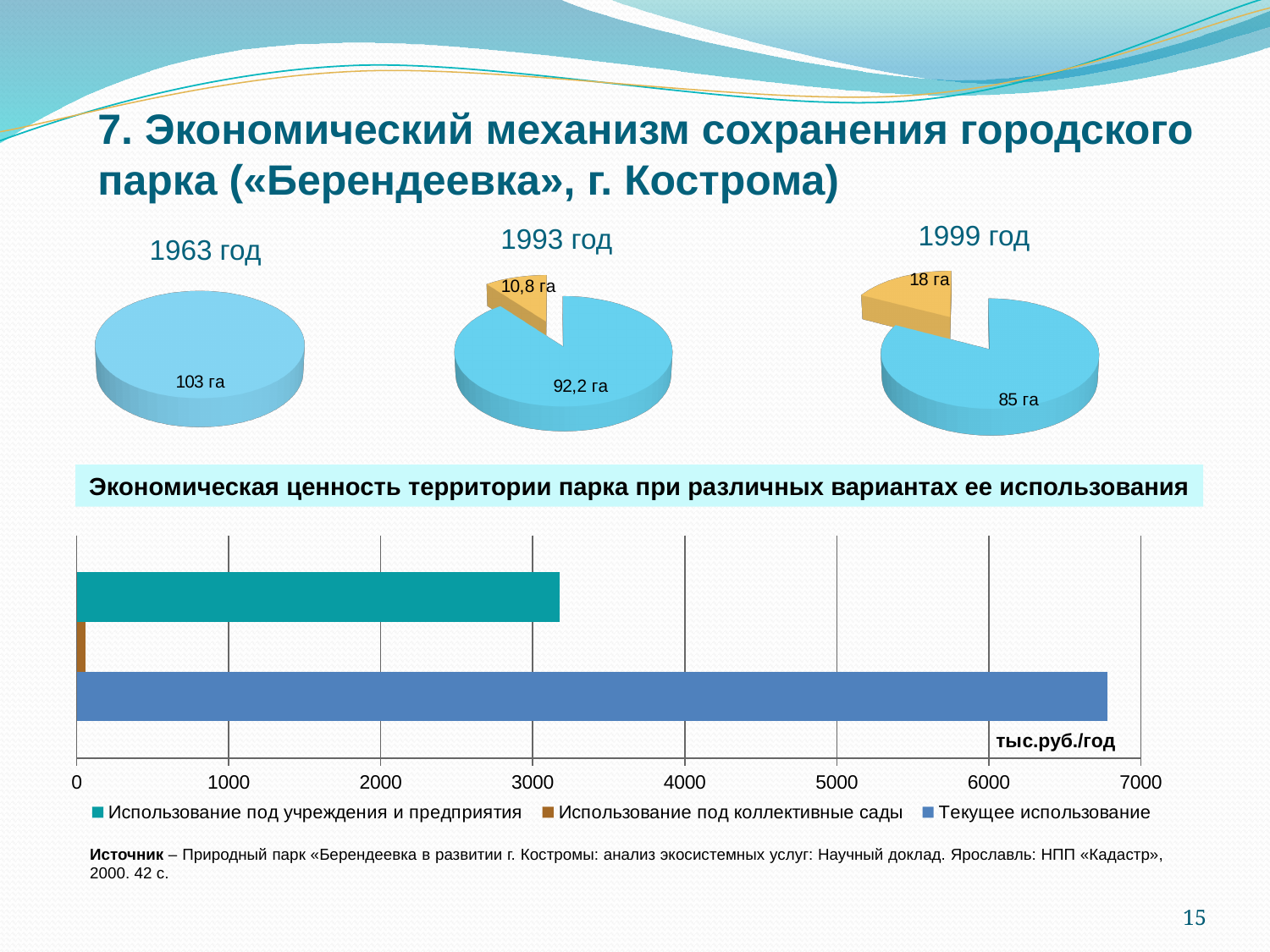
In the bottom bar chart, which series has the lowest value? Использование под коллективные сады In the 1999 год pie chart, what value is printed on the orange slice? 18 га In the bottom bar chart, is the value for «Текущее использование» greater or less than 6000? greater In the 1999 год pie chart, what value is printed on the blue slice? 85 га In the 1993 год pie chart, what is the difference between the blue slice value and the orange slice value? 81,4 га What kind of chart is the bottom chart titled «Экономическая ценность территории парка при различных вариантах ее использования»? bar chart How many pie charts are shown on the slide? 3 In the 1993 год pie chart, what value is printed on the smaller (orange) slice? 10,8 га In the 1999 год pie chart, which slice is larger, the blue one or the orange one? the blue one In the 1993 год pie chart, what value is printed on the larger (blue) slice? 92,2 га In the bottom bar chart, how many series does the legend list? 3 In the 1963 год pie chart, what value is printed on the slice? 103 га